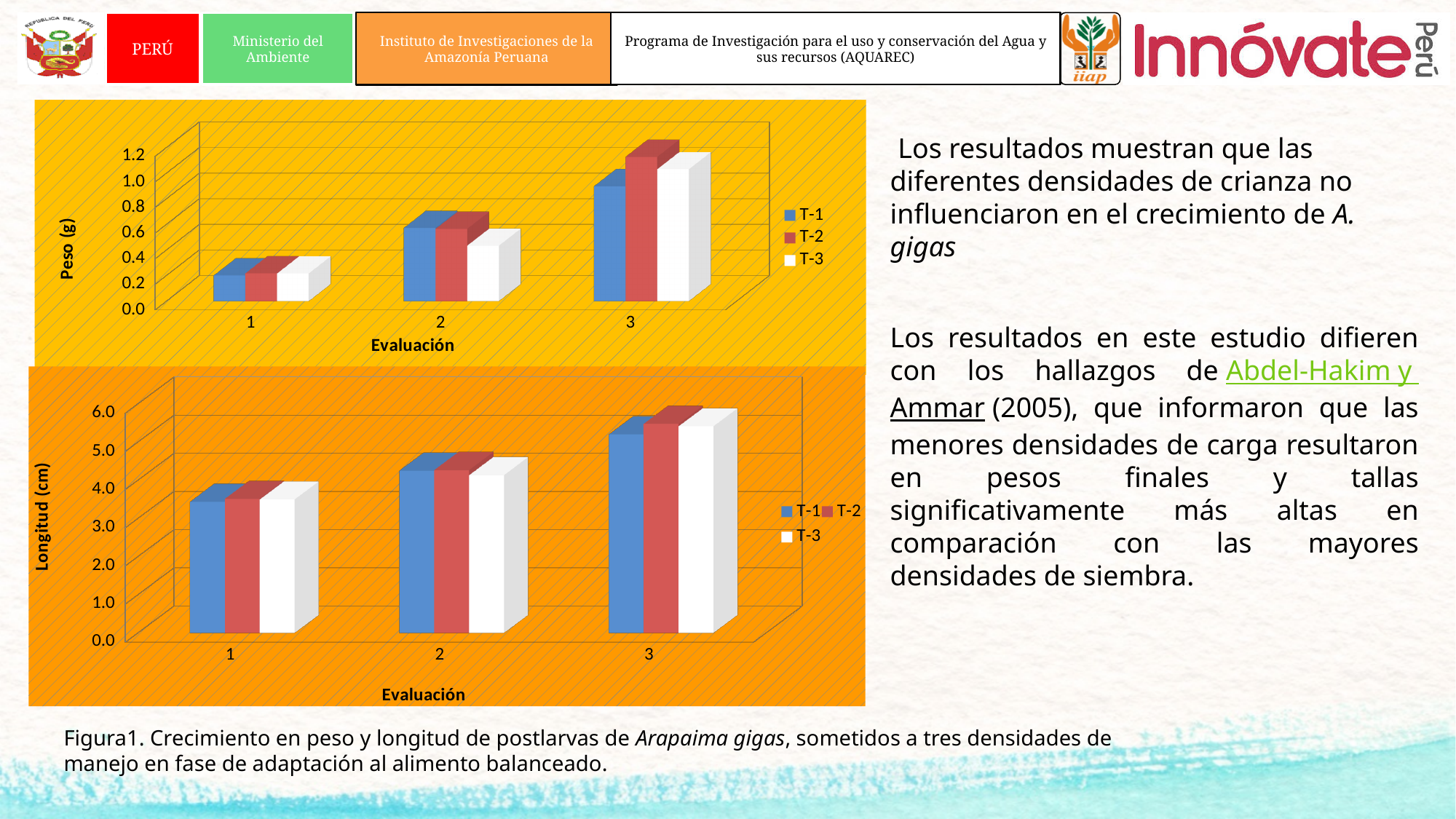
In the top chart (Peso (g)), is the value for T-1 at Evaluación 3 greater or less than 0.8? greater In the bottom chart (Longitud (cm)), which is larger for T-1: the value at Evaluación 1 or at Evaluación 3? Evaluación 3 What is the label of the vertical axis on the bottom chart? Longitud (cm) In the top chart (Peso (g)), do the T-1 values rise or fall from Evaluación 1 to Evaluación 3? rise In the bottom chart (Longitud (cm)), is the value for T-2 at Evaluación 2 greater or less than 5.0? less In the top chart (Peso (g)), is the value for T-1 at Evaluación 2 greater or less than 0.4? greater How many Evaluación categories are shown on the bottom chart (Longitud (cm))? 3 What kind of chart is the top chart (Peso (g))? bar chart How many series does the legend of the top chart (Peso (g)) list? 3